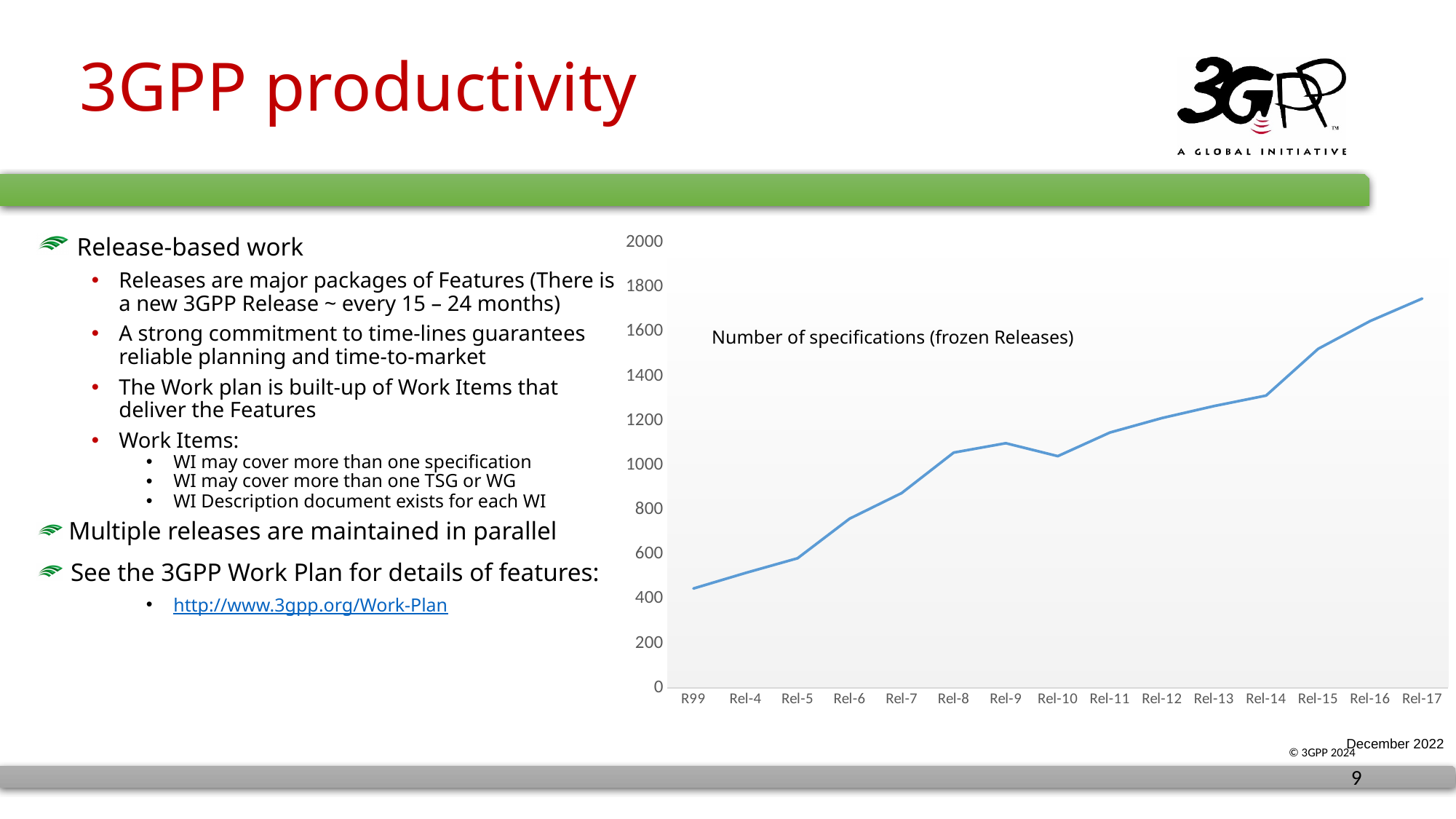
Which has more specifications, Rel-9 or Rel-10? Rel-9 What kind of chart is shown on the slide? line chart Is the value for R99 greater or less than 600? less How many releases are plotted along the x axis of the chart? 15 Which release has the lowest number of specifications? R99 What is the title shown on the chart? Number of specifications (frozen Releases) Is the value for Rel-14 greater or less than 1200? greater Is the value for Rel-17 greater or less than 1600? greater Do the values generally rise or fall from R99 to Rel-17? rise Which release has the highest number of specifications? Rel-17